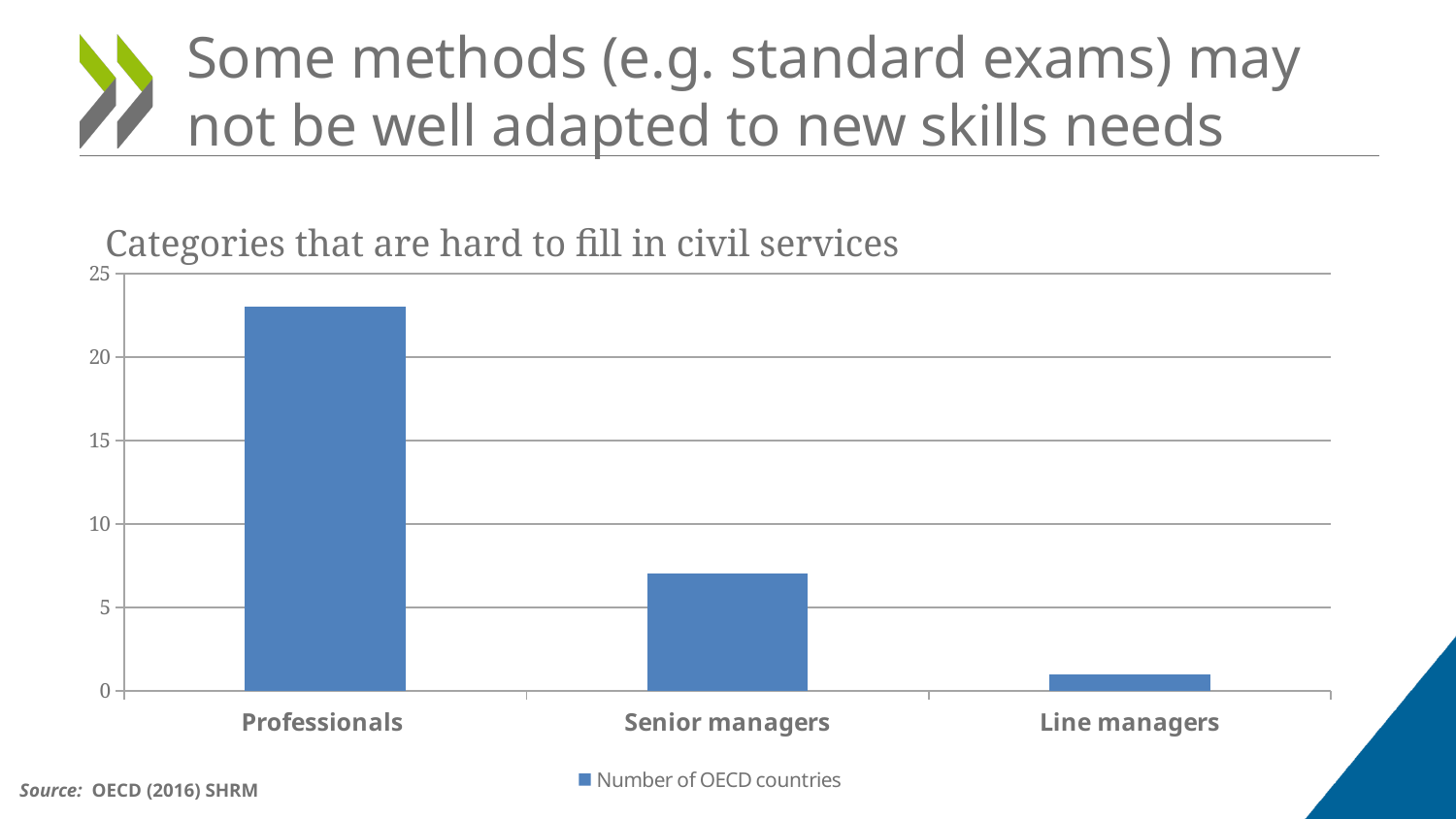
Is the value for Senior managers greater or less than 5? greater Is the value for Professionals greater or less than 20? greater What is the title of the chart? Categories that are hard to fill in civil services Which is larger, the value for Senior managers or the value for Line managers? Senior managers What kind of chart is shown on the slide? bar chart Is the value for Senior managers greater or less than 10? less Which category has the lowest value? Line managers How many series does the legend list? 1 How many categories are shown on the x axis? 3 Which category has the highest value? Professionals Do the values rise or fall moving from left to right along the x axis? fall